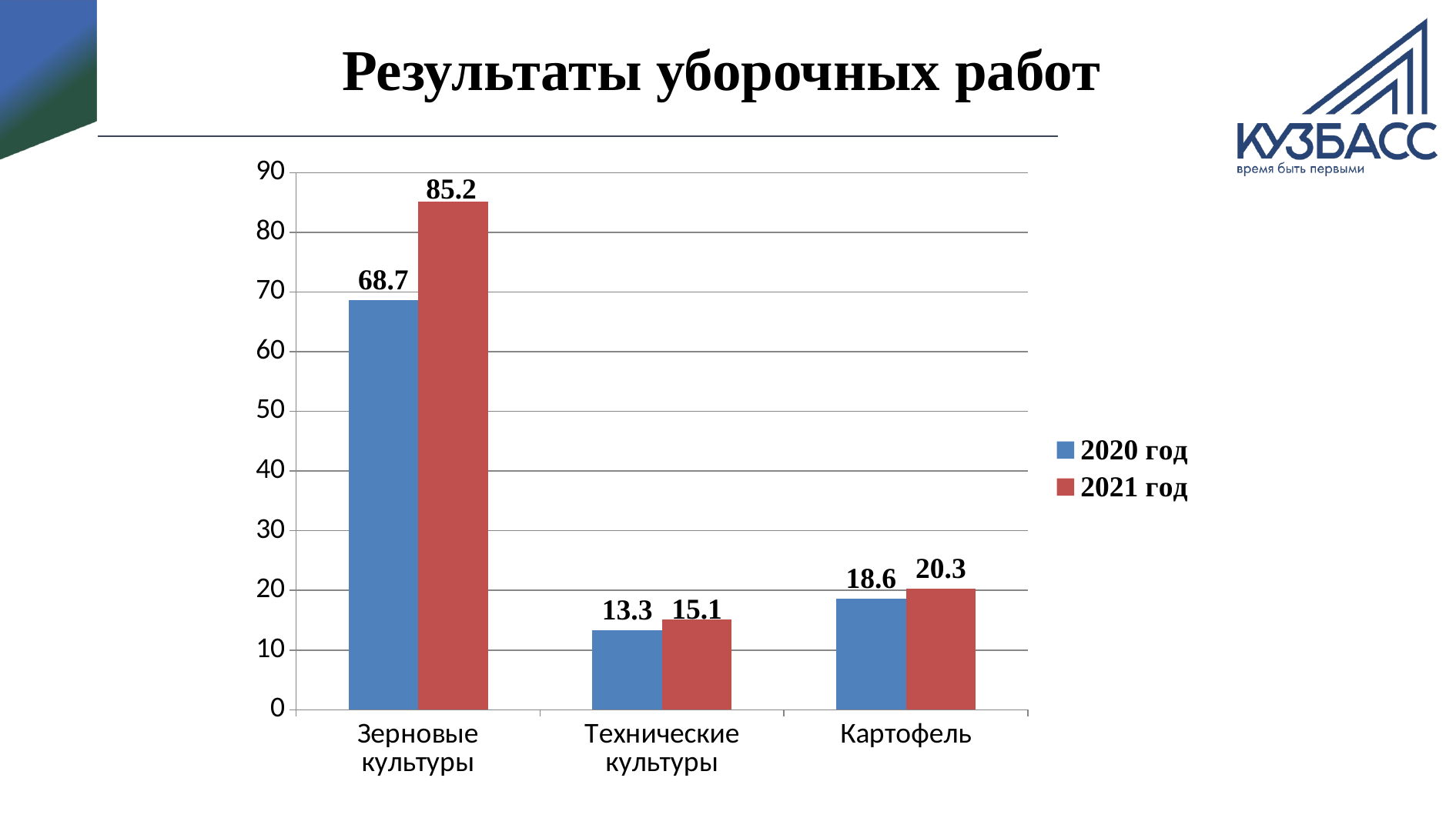
How many categories are shown on the x axis? 3 How many series does the legend list? 2 What is the value for Зерновые культуры in the 2020 год series? 68.7 Which is larger for Технические культуры: the 2020 год value or the 2021 год value? 2021 год What is the difference between the 2021 год and 2020 год values for Зерновые культуры? 16.5 Which category has the highest value in the 2021 год series? Зерновые культуры What kind of chart is shown on the slide? Bar chart What is the value for Картофель in the 2020 год series? 18.6 What is the value for Технические культуры in the 2021 год series? 15.1 What is the value for Зерновые культуры in the 2021 год series? 85.2 Which category has the lowest value in the 2020 год series? Технические культуры What is the difference between the 2021 год and 2020 год values for Картофель? 1.7